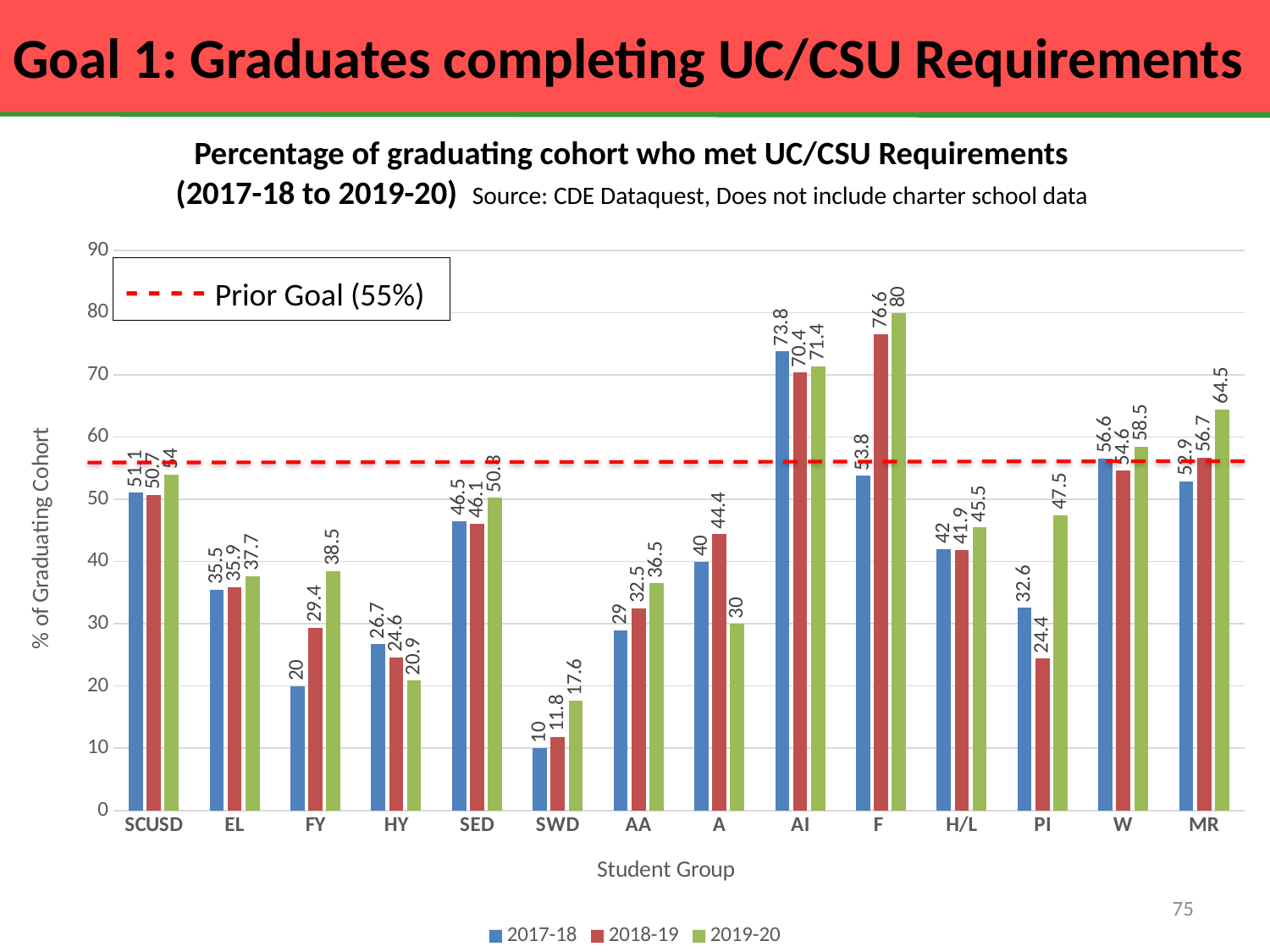
How many series does the legend at the bottom of the chart list? 3 Which student group has the highest value in 2019-20? F What kind of chart is shown on the slide? bar chart What is the value for SWD in 2017-18? 10 What is the value for FY in 2019-20? 38.5 How many student groups are shown on the x axis? 14 What is the Prior Goal value shown by the dashed red line? 55% What is the difference between the 2019-20 and 2017-18 values for F? 26.2 Is the value for PI in 2019-20 greater or less than 40? greater Which student group has the lowest value in 2018-19? SWD What is the value for HY in 2019-20? 20.9 In 2017-18, which is larger: the value for AI or the value for F? AI